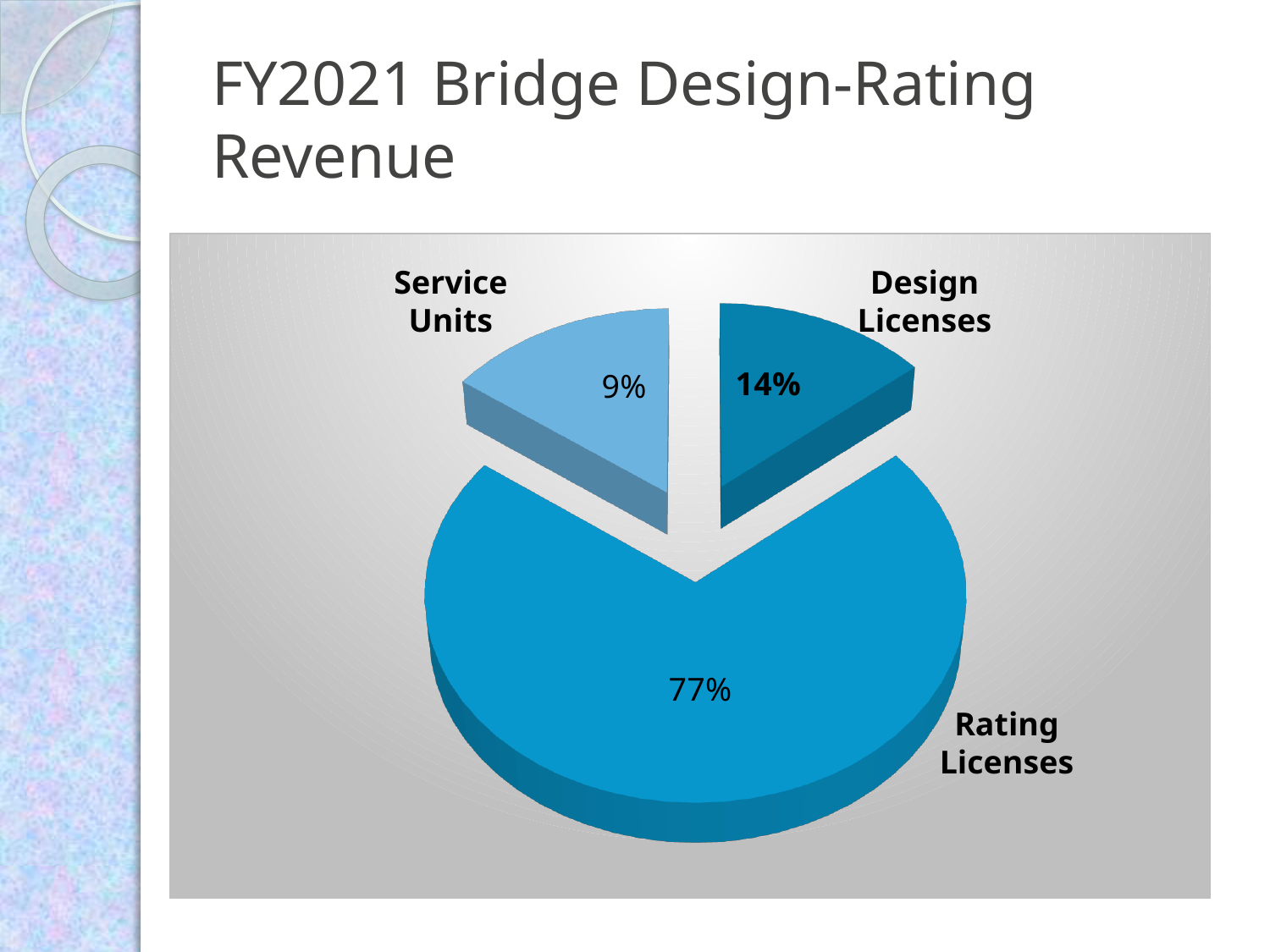
What is the difference in percentage points between Rating Licenses and Design Licenses? 63 What share of revenue comes from Design Licenses? 14% What is the difference in percentage points between Design Licenses and Service Units? 5 What is the combined share of Design Licenses and Service Units? 23% What kind of chart is shown on the slide? Pie chart What is the title of the slide containing the chart? FY2021 Bridge Design-Rating Revenue Which category has the largest share of revenue? Rating Licenses What share of revenue comes from Rating Licenses? 77% Which is larger, the share for Design Licenses or the share for Service Units? Design Licenses How many slices does the pie chart have? 3 Which category has the smallest share of revenue? Service Units What share of revenue comes from Service Units? 9%